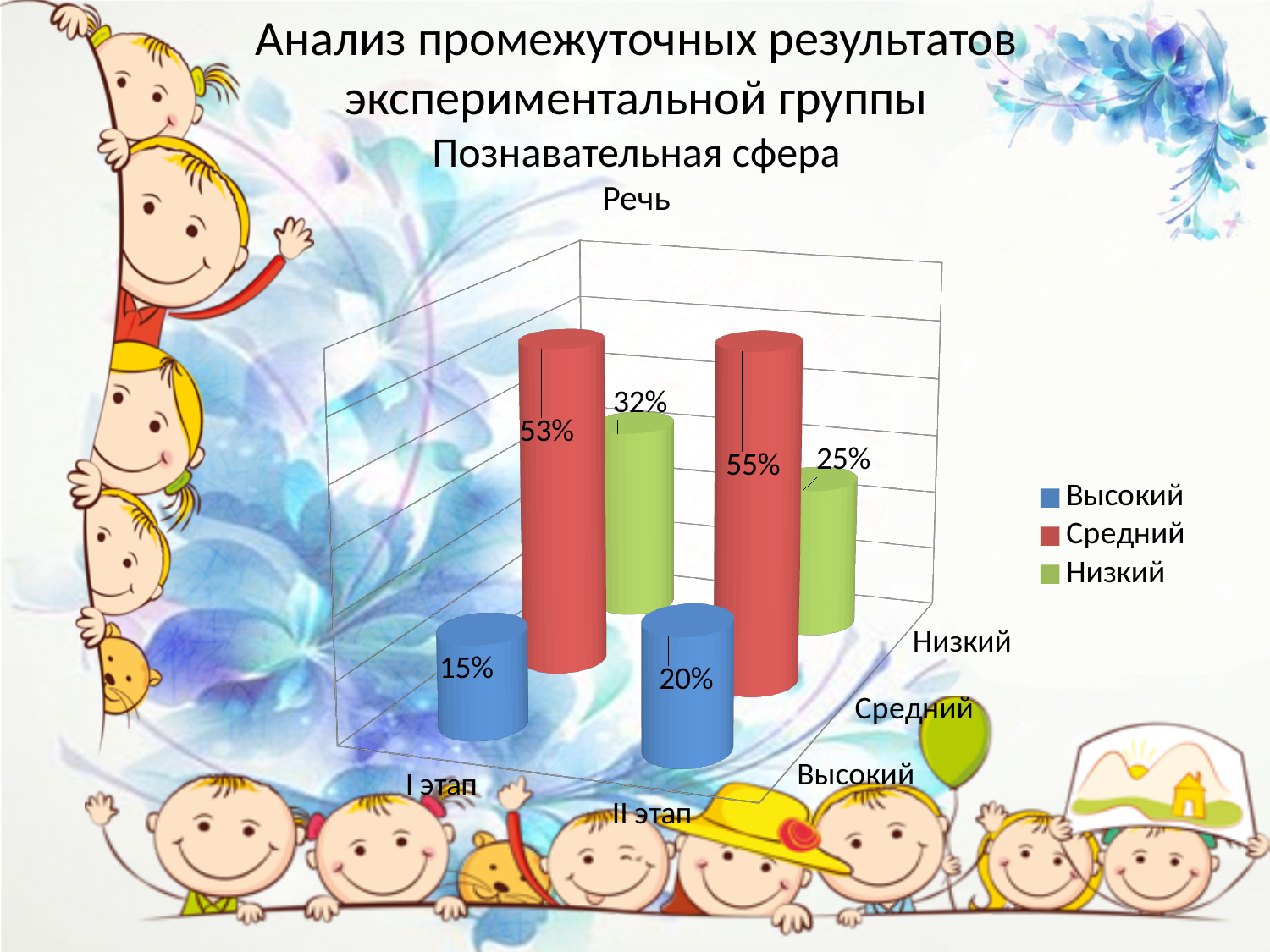
Which is larger: Низкий at I этап or Низкий at II этап? Низкий at I этап What is the difference between the Средний values at II этап and I этап? 2% What is the value for Средний at II этап? 55% What is the value for Низкий at I этап? 32% What is the title of the chart? Речь Which series has the lowest value at II этап? Высокий Which series has the highest value at I этап? Средний What is the value for Низкий at II этап? 25% What is the value for Высокий at I этап? 15% How many stages (categories) are shown on the x axis? 2 How many series does the legend list? 3 What kind of chart is shown? bar chart